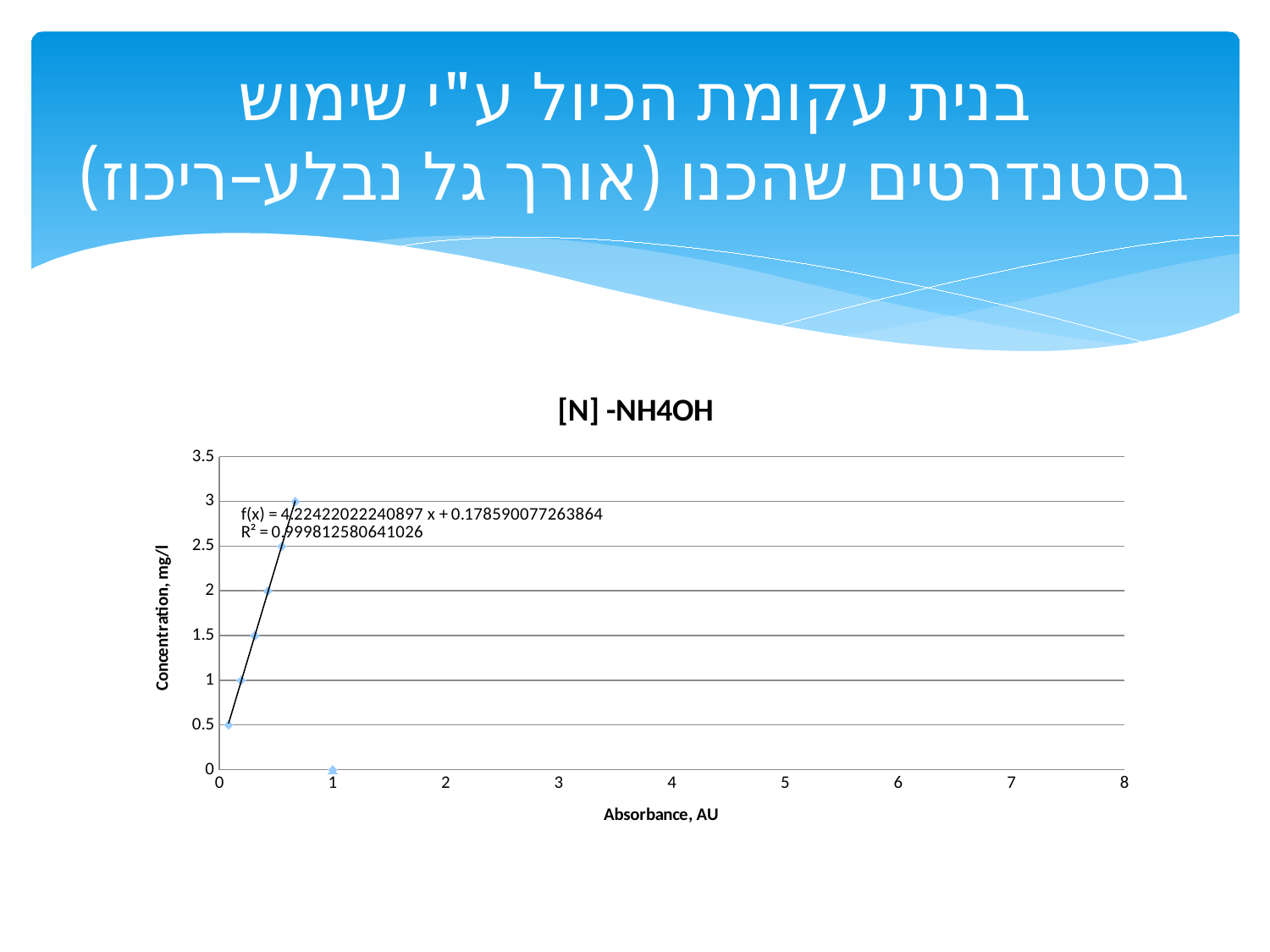
Is the absorbance of the point with the highest concentration greater or less than 1? less What is the maximum value shown on the x axis of the chart? 8 What is the R² value shown on the chart? 0.999812580641026 What is the maximum value shown on the y axis of the chart? 3.5 What is the label of the x axis of the chart? Absorbance, AU Does the concentration rise or fall as absorbance increases along the trendline? rise What kind of chart is shown on the slide? scatter chart What is the slope of the trendline equation shown on the chart? 4.22422022240897 What is the intercept of the trendline equation shown on the chart? 0.178590077263864 How many data points are plotted on the chart? 7 What is the title of the chart? [N] -NH4OH What is the highest concentration value plotted on the chart? 3